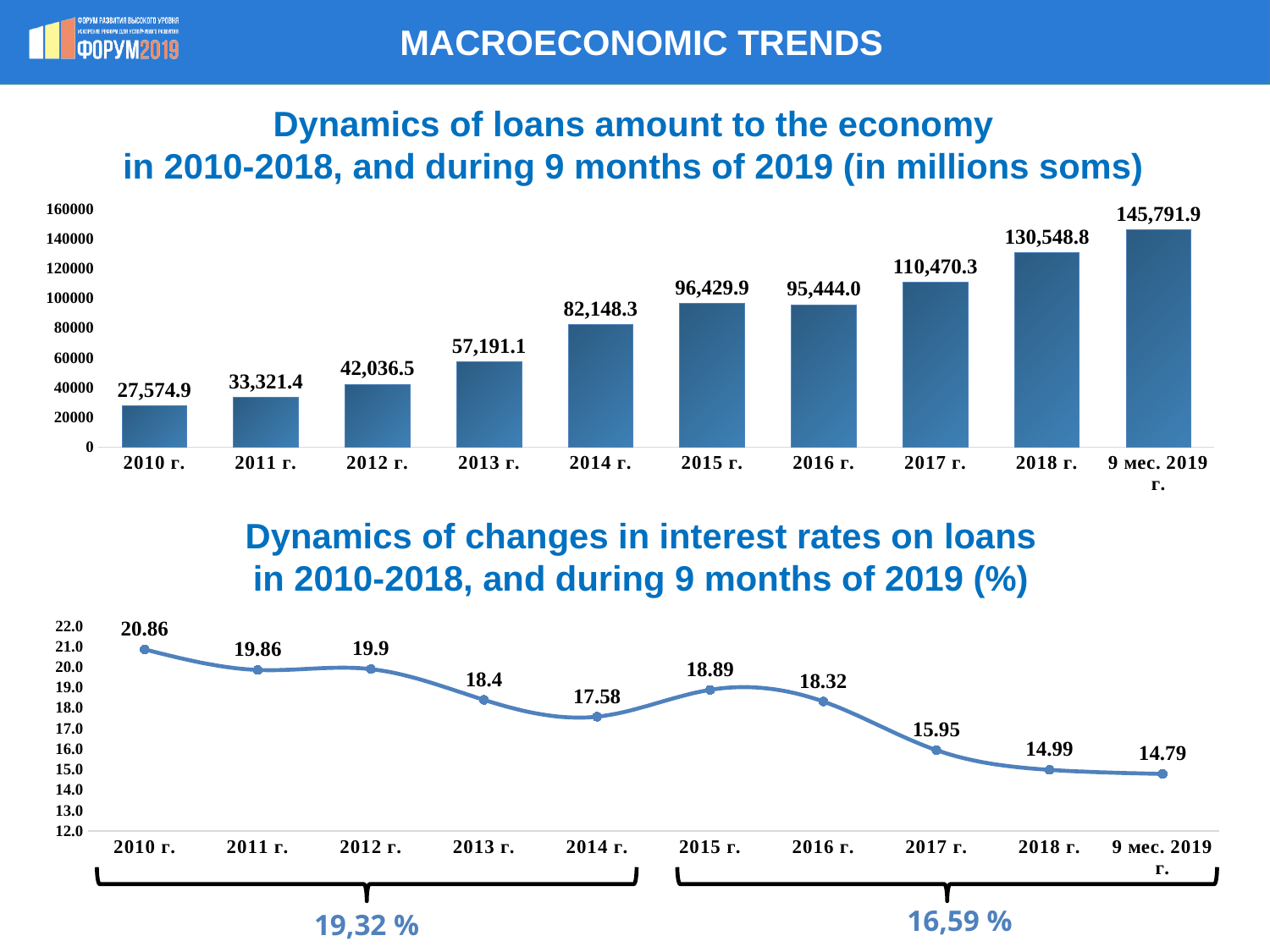
In the top chart (Dynamics of loans amount to the economy), which category has the highest value? 9 мес. 2019 г. What kind of chart is the bottom chart (Dynamics of changes in interest rates on loans)? Line chart In the top chart (Dynamics of loans amount to the economy), which category has the lowest value? 2010 г. In the bottom chart (Dynamics of changes in interest rates on loans), which category has the lowest value? 9 мес. 2019 г. In the top chart (Dynamics of loans amount to the economy), how many categories are shown on the x axis? 10 What kind of chart is the top chart (Dynamics of loans amount to the economy)? Bar chart In the top chart (Dynamics of loans amount to the economy), do the values generally rise or fall from 2010 г. to 9 мес. 2019 г.? Rise In the bottom chart (Dynamics of changes in interest rates on loans), what is the difference between the values for 2010 г. and 2014 г.? 3.28 In the top chart (Dynamics of loans amount to the economy), which is larger, the value for 2015 г. or 2016 г.? 2015 г. In the top chart (Dynamics of loans amount to the economy), what is the value for 2014 г.? 82,148.3 In the top chart (Dynamics of loans amount to the economy), what is the difference between the values for 2018 г. and 2017 г.? 20,078.5 In the bottom chart (Dynamics of changes in interest rates on loans), what is the value for 2017 г.? 15.95